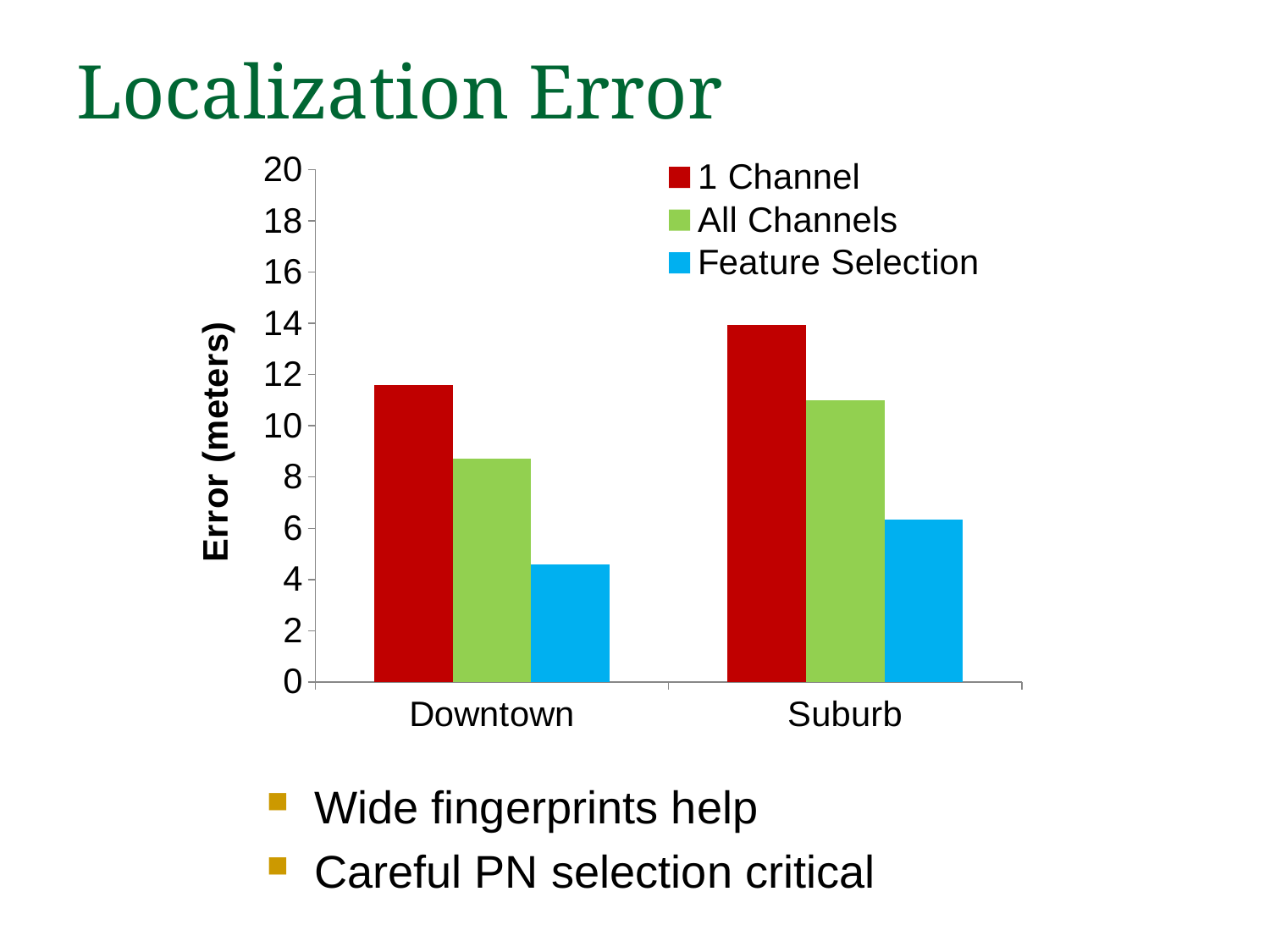
What is the label of the y axis? Error (meters) Which is larger, the All Channels error for Downtown or the All Channels error for Suburb? Suburb How many series does the legend list? 3 What kind of chart is shown on the slide? bar chart Which series has the lowest error in the Downtown category? Feature Selection Is the Feature Selection error for Downtown greater or less than 6? less Is the 1 Channel error for Downtown greater or less than 10? greater Which series has the highest error in the Suburb category? 1 Channel How many categories are shown on the x axis? 2 Is the Feature Selection error for Suburb greater or less than 8? less Which colour represents the Feature Selection series? blue